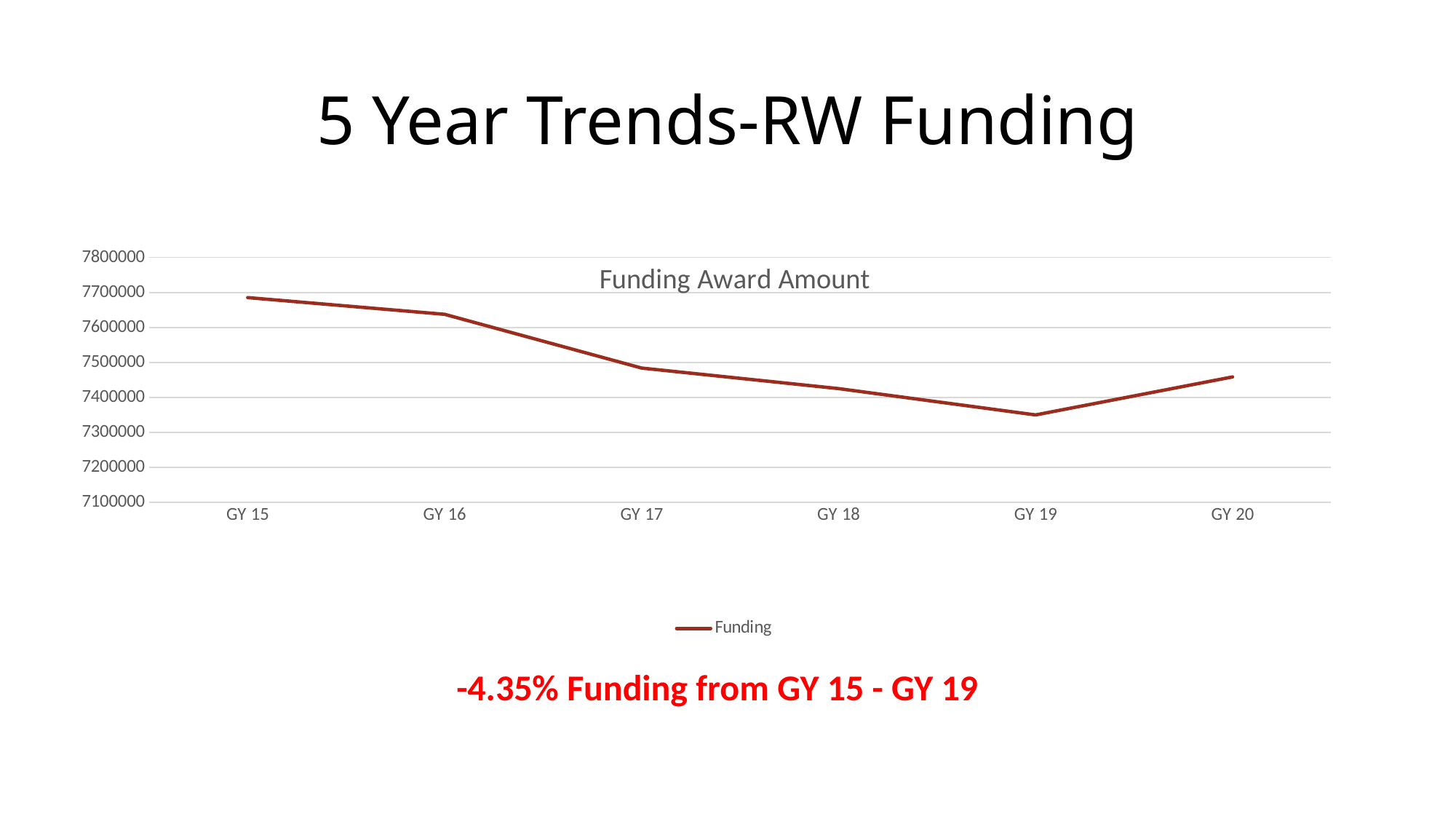
Which grant year has the highest funding award amount? GY 15 Is the funding value for GY 20 greater or less than 7400000? greater What kind of chart is shown on the slide? line chart How many series does the legend list? 1 How many grant years are plotted on the x axis? 6 What series name does the legend list? Funding Which has the larger funding value, GY 16 or GY 17? GY 16 Do the funding values rise or fall from GY 15 to GY 19? fall What is the title of the chart? Funding Award Amount Is the funding value for GY 19 greater or less than 7400000? less Which grant year has the lowest funding award amount? GY 19 Is the funding value for GY 15 greater or less than 7600000? greater